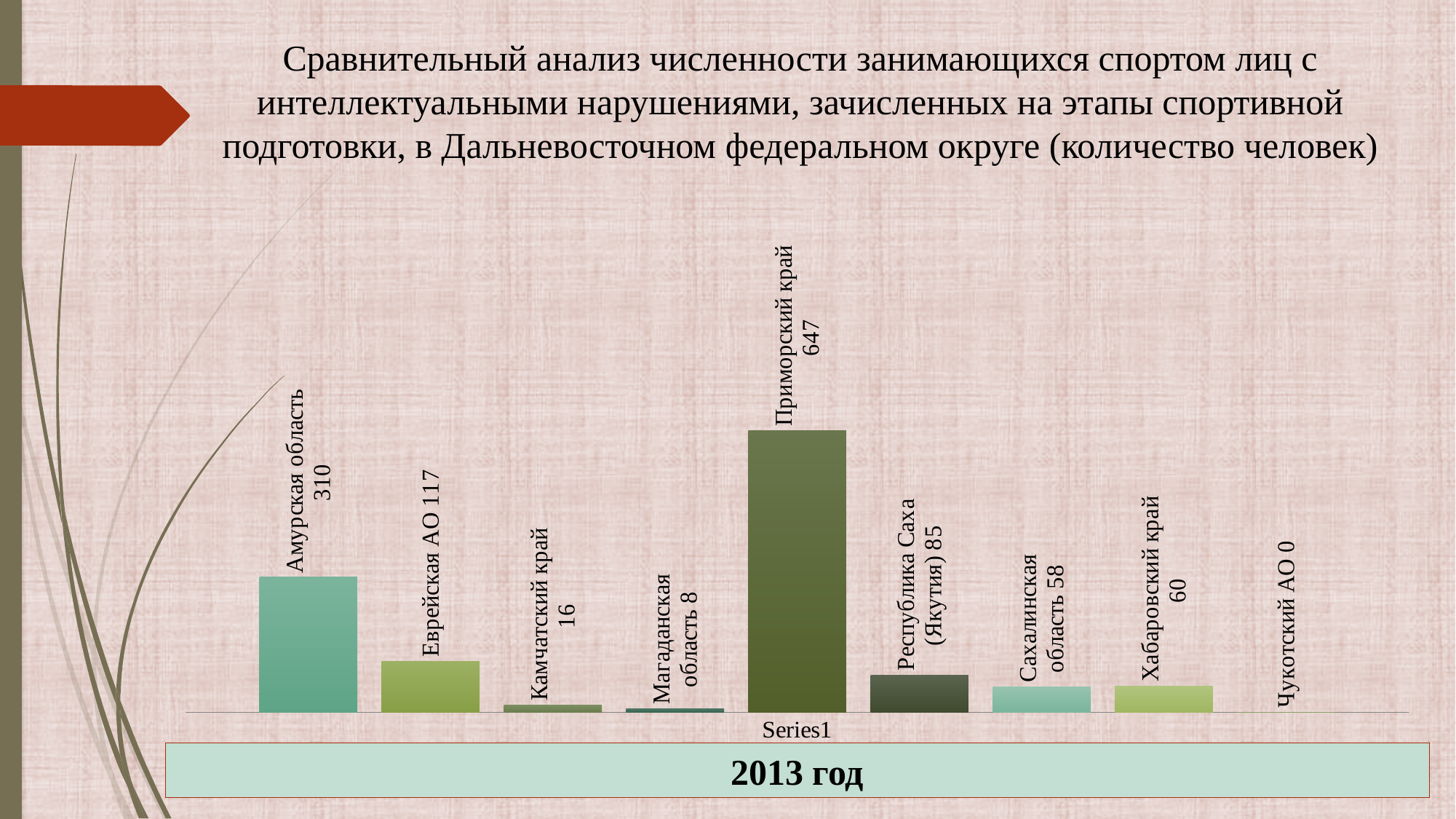
Which region has the lowest value? Чукотский АО Which year does the chart refer to, according to the label below it? 2013 год What is the value for Амурская область? 310 What is the difference between the values for Приморский край and Амурская область? 337 What is the value for Чукотский АО? 0 What is the difference between the values for Еврейская АО and Сахалинская область? 59 What kind of chart is shown on the slide? Bar chart What is the value for Республика Саха (Якутия)? 85 Which is larger, the value for Хабаровский край or the value for Сахалинская область? Хабаровский край What is the value for Приморский край? 647 How many regions are shown in the chart? 9 Which region has the highest value? Приморский край